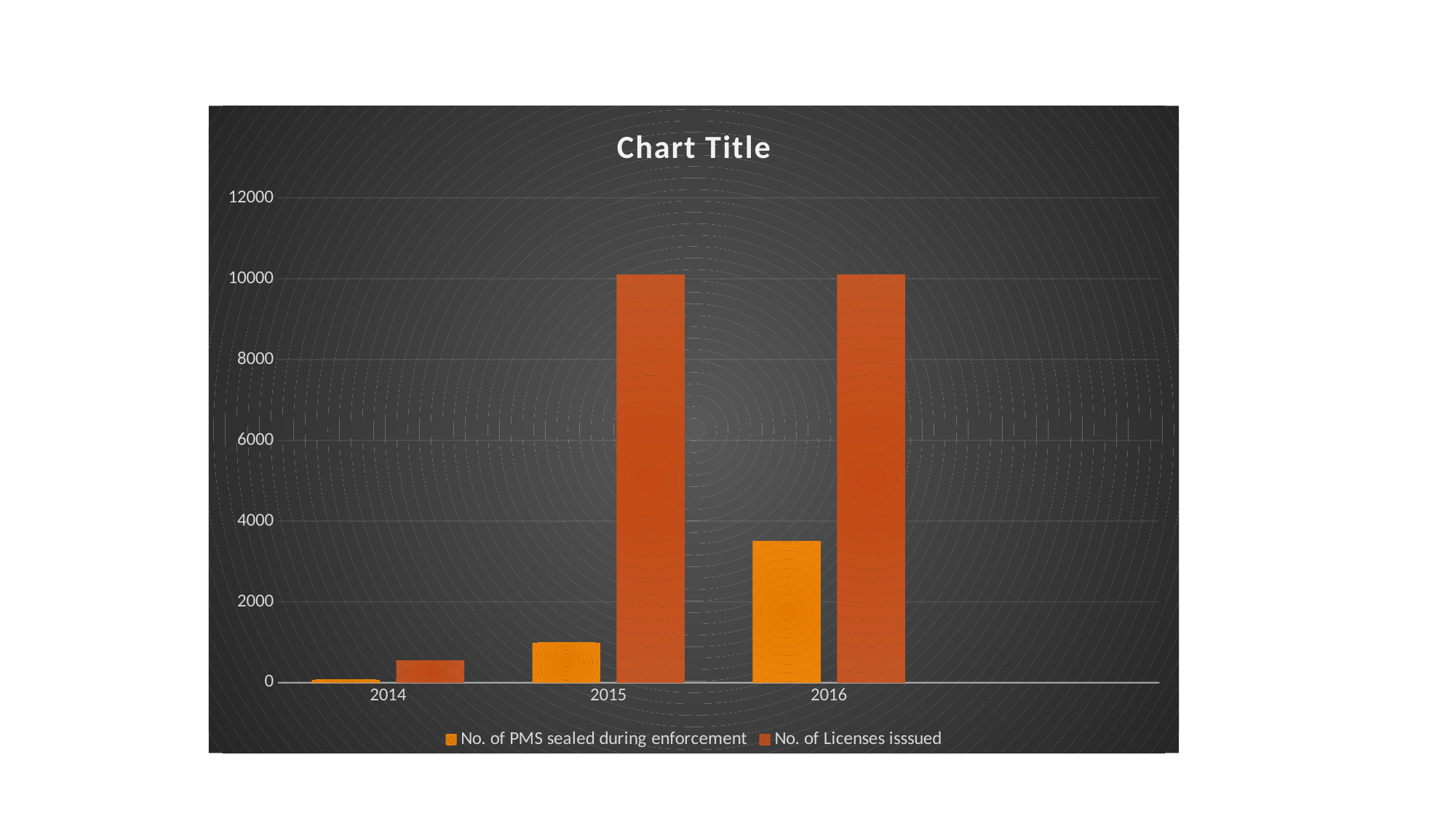
In which year is the value for No. of Licenses isssued lowest? 2014 In which year is the value for No. of PMS sealed during enforcement highest? 2016 Does the value for No. of PMS sealed during enforcement rise or fall from 2014 to 2016? rise Is the value for No. of PMS sealed during enforcement in 2016 greater or less than 4000? less Which series is shown in the lighter orange colour in the legend? No. of PMS sealed during enforcement In 2016, which is larger: No. of PMS sealed during enforcement or No. of Licenses isssued? No. of Licenses isssued How many series does the chart's legend list? 2 What kind of chart is shown on the slide? bar chart How many years are shown on the x axis of the chart? 3 In which year is the value for No. of PMS sealed during enforcement lowest? 2014 What is the title of the chart? Chart Title